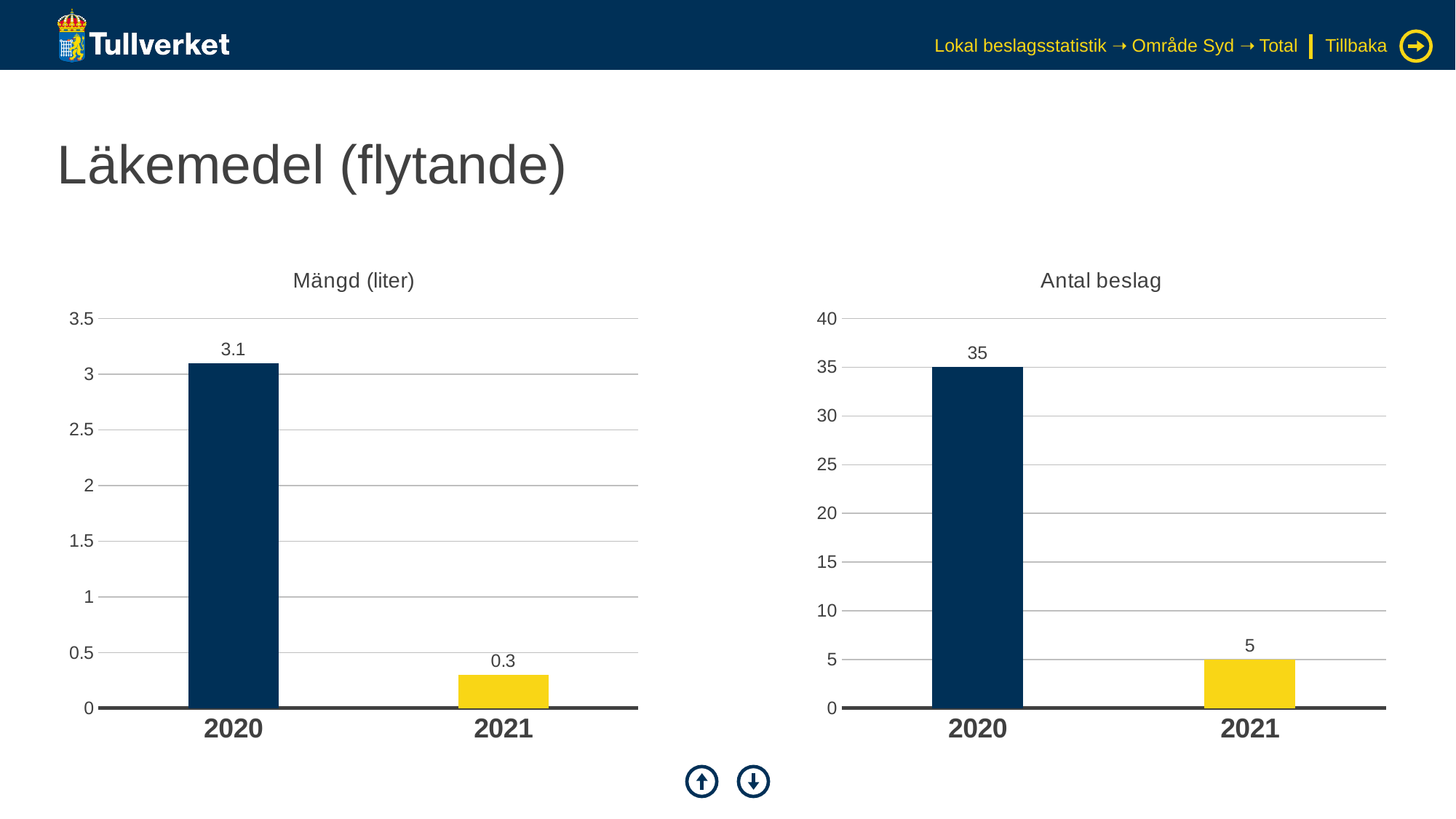
In the 'Mängd (liter)' chart, what is the value for 2020? 3.1 In the 'Mängd (liter)' chart, what is the difference between the 2020 and 2021 values? 2.8 How many categories are shown on the x axis of the 'Mängd (liter)' chart? 2 In the 'Antal beslag' chart, what is the value for 2020? 35 In the 'Antal beslag' chart, which year has the lowest value? 2021 In the 'Mängd (liter)' chart, do the values rise or fall from 2020 to 2021? fall In the 'Antal beslag' chart, what is the value for 2021? 5 In the 'Antal beslag' chart, is the value for 2020 greater or less than 30? greater In the 'Mängd (liter)' chart, what is the value for 2021? 0.3 In the 'Antal beslag' chart, what is the difference between the 2020 and 2021 values? 30 In the 'Mängd (liter)' chart, which year has the highest value? 2020 What kind of chart is the 'Antal beslag' chart? bar chart